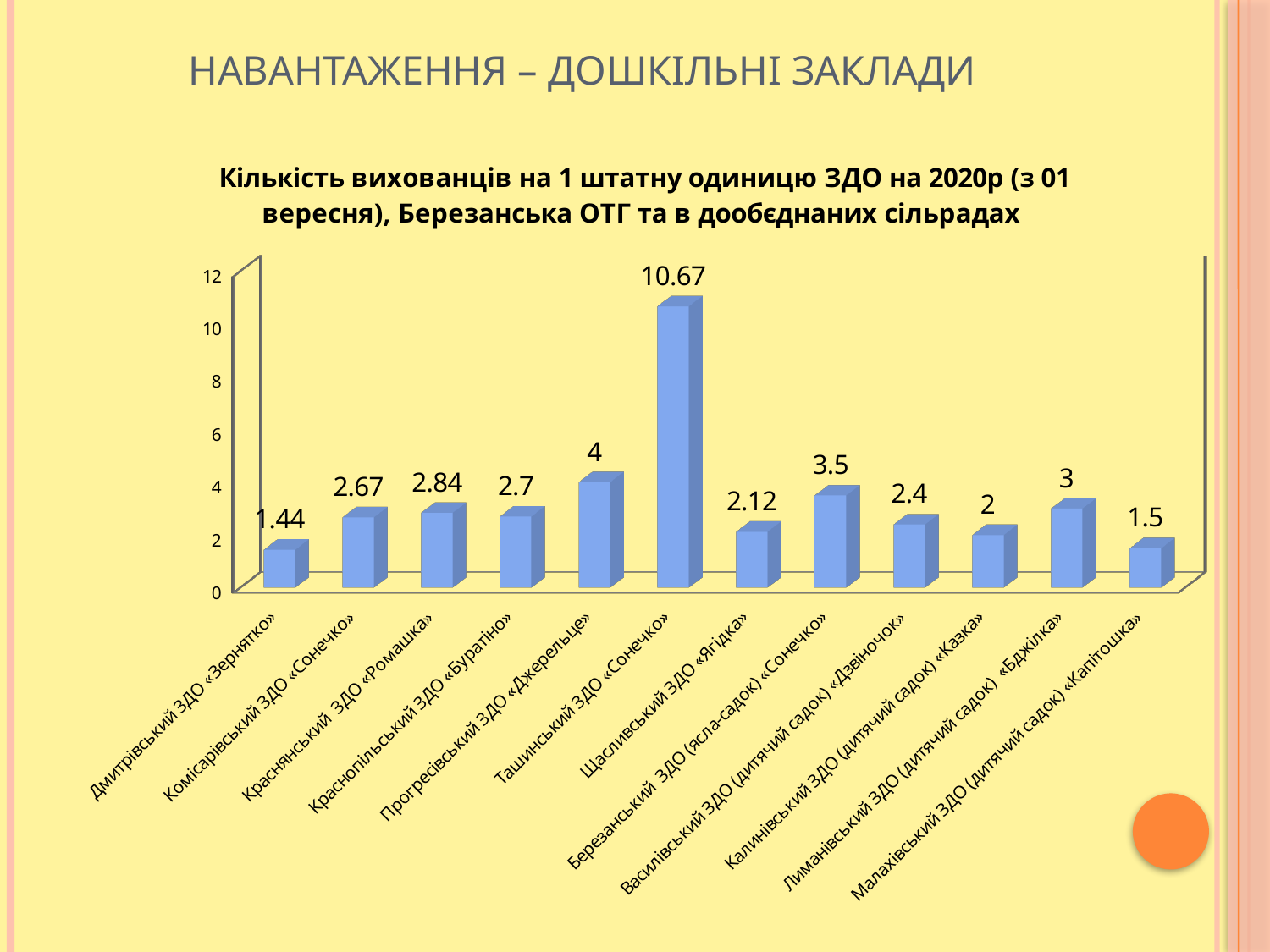
What kind of chart is shown on the slide? bar chart What is the value for Березанський ЗДО (ясла-садок) «Сонечко»? 3.5 What is the difference between the values for Ташинський ЗДО «Сонечко» and Прогресівський ЗДО «Джерельце»? 6.67 What is the value for Ташинський ЗДО «Сонечко»? 10.67 What is the value for Краснянський ЗДО «Ромашка»? 2.84 How many categories are shown on the chart? 12 What is the value for Малахівський ЗДО (дитячий садок) «Капітошка»? 1.5 Which is larger: the value for Лиманівський ЗДО (дитячий садок) «Бджілка» or Калинівський ЗДО (дитячий садок) «Казка»? Лиманівський ЗДО (дитячий садок) «Бджілка» What is the value for Дмитрівський ЗДО «Зернятко»? 1.44 Is the value for Прогресівський ЗДО «Джерельце» greater or less than 2? greater Which category has the highest value? Ташинський ЗДО «Сонечко» Which category has the lowest value? Дмитрівський ЗДО «Зернятко»